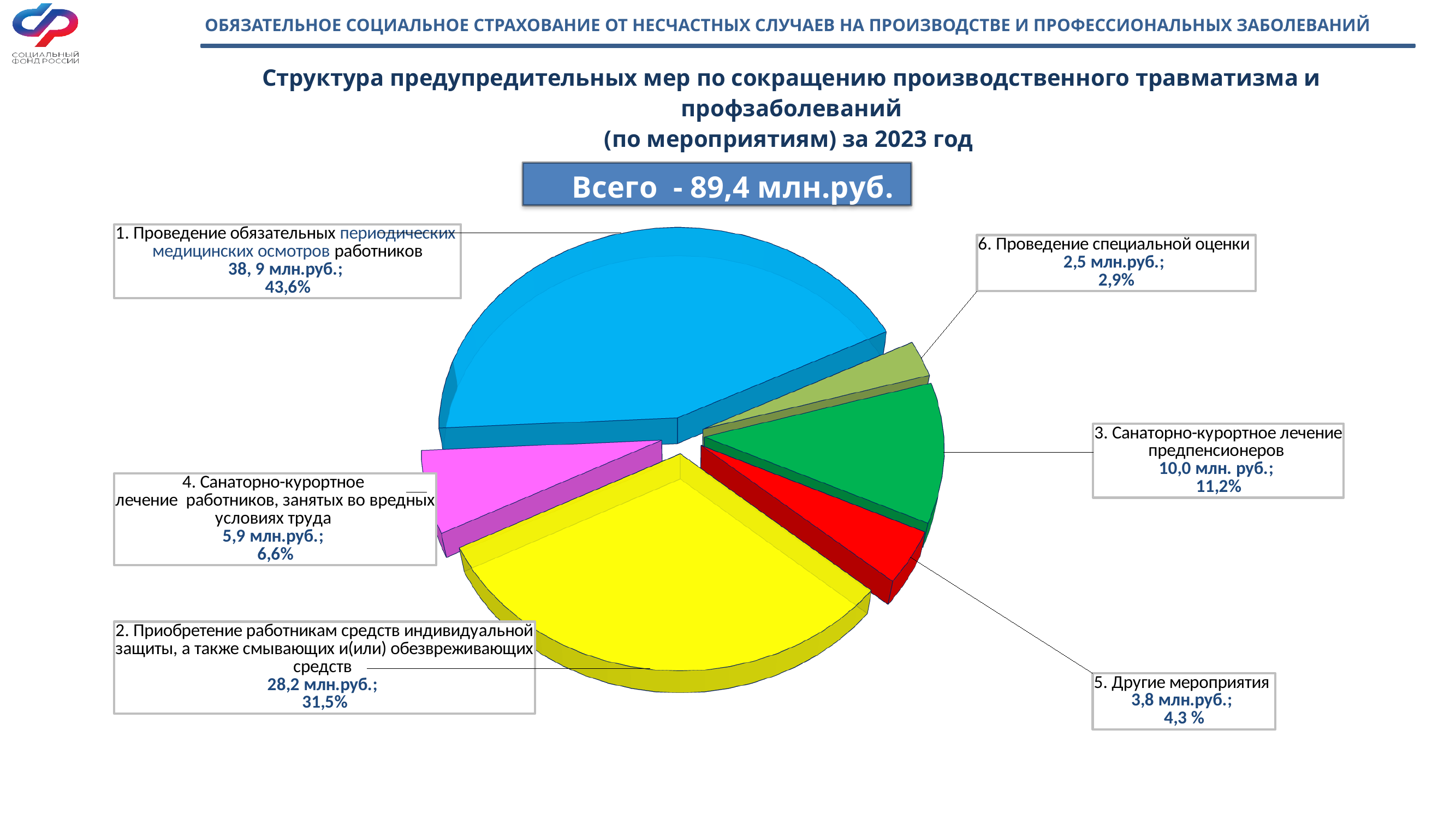
Какова общая сумма расходов на предупредительные меры за 2023 год, указанная на слайде? 89,4 млн.руб. Что больше: расходы на санаторно-курортное лечение предпенсионеров или на санаторно-курортное лечение работников, занятых во вредных условиях труда? Санаторно-курортное лечение предпенсионеров Сколько мероприятий (секторов) показано на круговой диаграмме? 6 Какая сумма приходится на санаторно-курортное лечение предпенсионеров? 10,0 млн. руб. Какое мероприятие имеет наибольшую долю в структуре предупредительных мер? Проведение обязательных периодических медицинских осмотров работников Какова доля приобретения работникам средств индивидуальной защиты в структуре предупредительных мер? 31,5% Какой тип диаграммы показан на слайде? Круговая диаграмма На сколько млн.руб. расходы на периодические медицинские осмотры превышают расходы на средства индивидуальной защиты? 10,7 млн.руб. Какая сумма приходится на проведение обязательных периодических медицинских осмотров работников? 38, 9 млн.руб. Какое мероприятие имеет наименьшую долю в структуре предупредительных мер? Проведение специальной оценки Какова доля проведения специальной оценки? 2,9% Каким цветом на диаграмме показан сектор «Другие мероприятия»? Красным